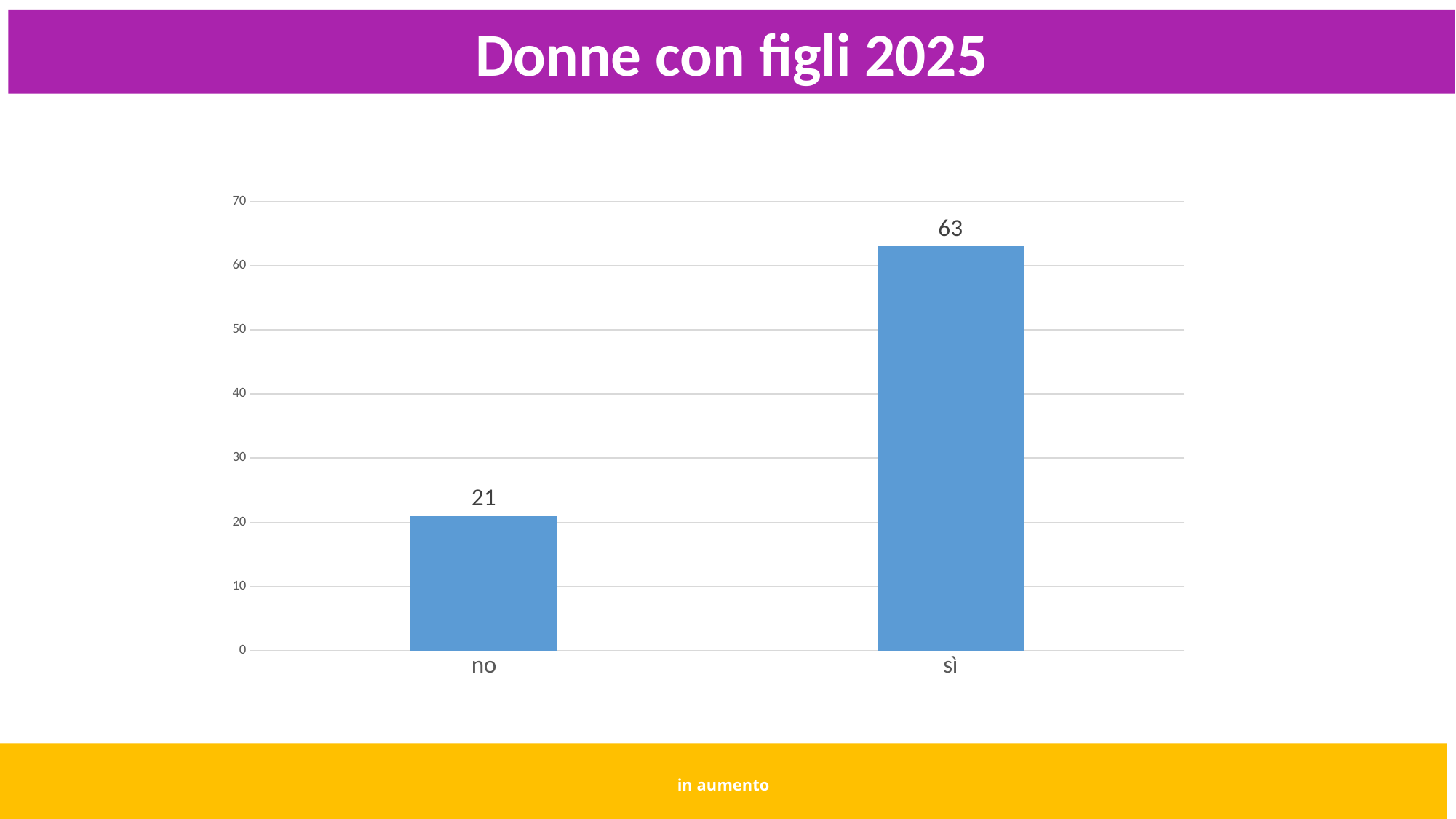
What is the title of the slide? Donne con figli 2025 What is the value for "no"? 21 What is the highest value shown on the vertical axis? 70 Is the value for "sì" greater or less than 60? greater Which category has the highest value? sì What kind of chart is shown on the slide? bar chart What is the difference between the values for "sì" and "no"? 42 How many categories are shown on the x axis? 2 Which category has the lowest value? no Is the value for "no" greater or less than 30? less Which is larger, the value for "no" or the value for "sì"? sì What is the value for "sì"? 63